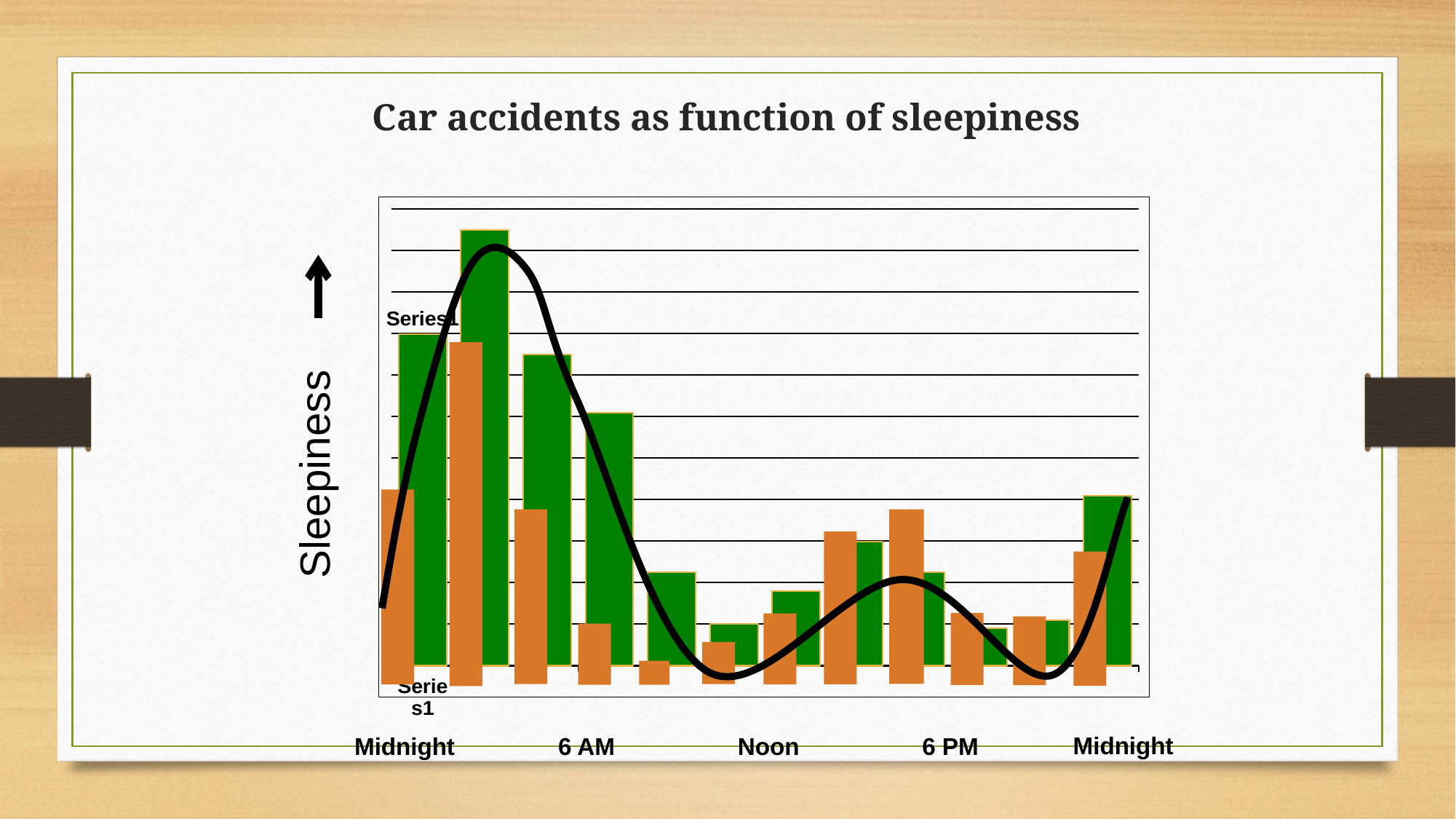
How many time labels are shown along the x axis? 5 Which is taller: the green bar at 6 AM or the green bar at Noon? 6 AM What is the title of the chart? Car accidents as function of sleepiness Do the green bars rise or fall going from 6 AM to Noon? Fall What label is written along the vertical axis of the chart? Sleepiness Which x-axis label appears at both the left and right ends of the axis? Midnight Between which two x-axis labels does the black curve reach its highest point? Between Midnight and 6 AM What type of chart is shown on the slide? Bar chart Between which two x-axis labels does the tallest orange bar appear? Between Midnight and 6 AM Between which two x-axis labels does the tallest green bar appear? Between Midnight and 6 AM